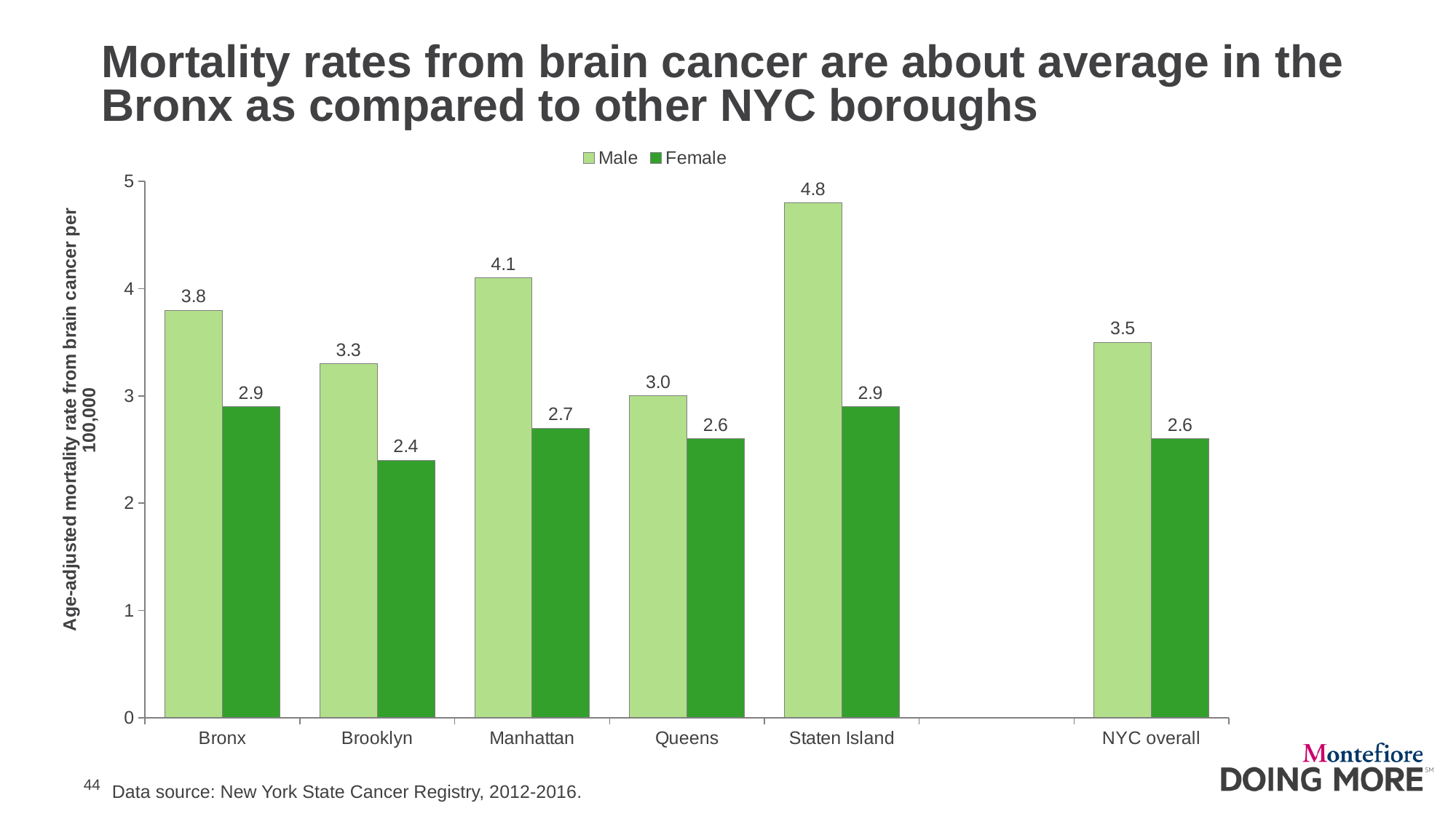
What is the Male mortality rate for Staten Island? 4.8 Which borough has the highest Male mortality rate? Staten Island Which category has the lowest Female mortality rate? Brooklyn Which is larger, the Male rate for Manhattan or the Male rate for Queens? Manhattan What is the Male mortality rate for NYC overall? 3.5 What kind of chart is shown on the slide? Bar chart How many categories are shown on the x axis? 6 What is the label of the vertical axis? Age-adjusted mortality rate from brain cancer per 100,000 How many series does the legend list? 2 What is the Female mortality rate for Brooklyn? 2.4 Is the Male mortality rate for Queens greater or less than 4? less What is the difference between the Male and Female mortality rates in the Bronx? 0.9